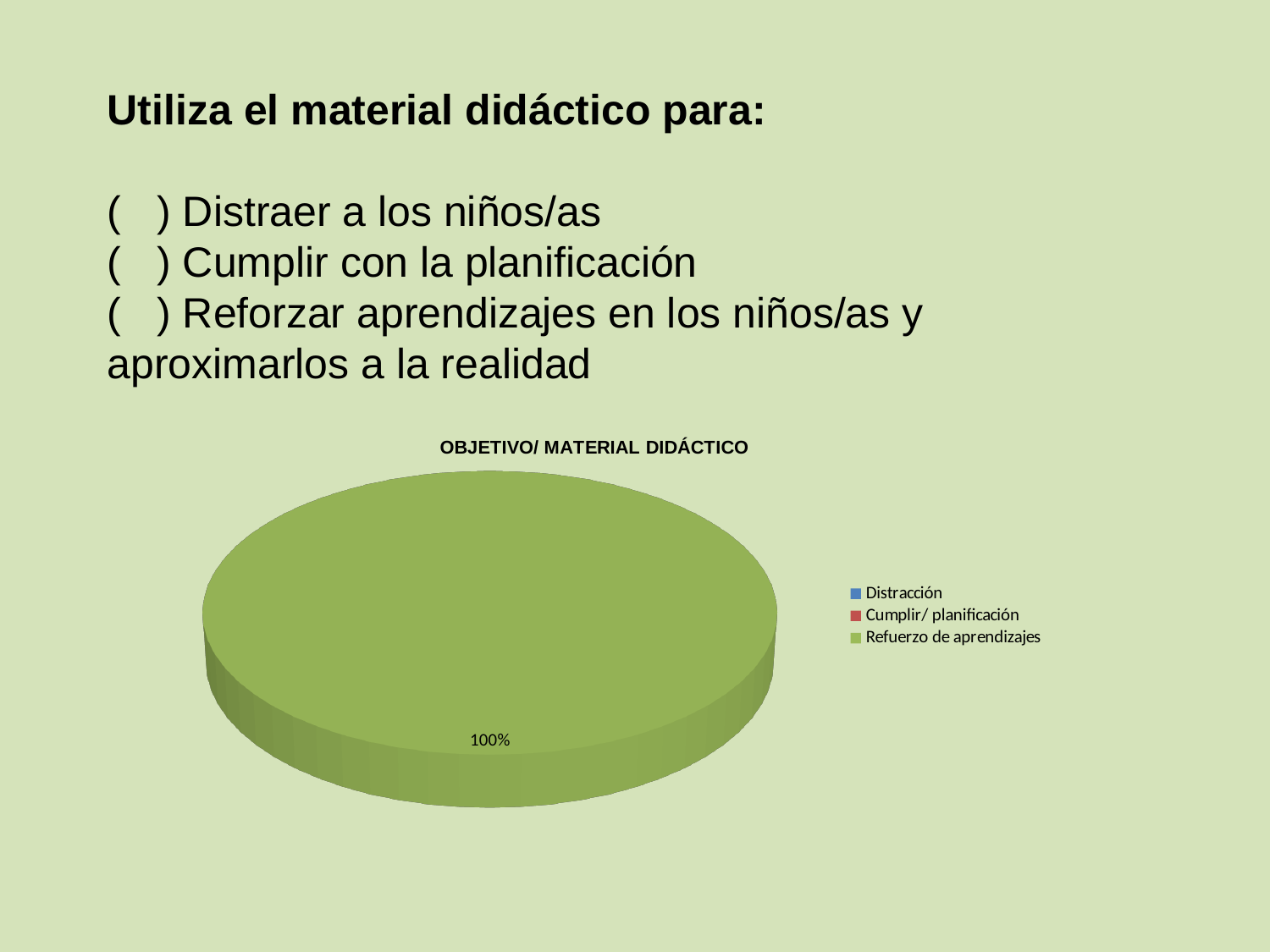
What is the title of the chart? OBJETIVO/ MATERIAL DIDÁCTICO What share of the pie does Refuerzo de aprendizajes have? 100% Which is larger, the share for Refuerzo de aprendizajes or the share for Distracción? Refuerzo de aprendizajes What is the only percentage label printed on the pie? 100% What kind of chart is shown on the slide? pie chart What colour is the slice for Refuerzo de aprendizajes? green How many categories does the chart's legend list? 3 Which is larger, the share for Cumplir/ planificación or the share for Refuerzo de aprendizajes? Refuerzo de aprendizajes Which category has the largest share of the pie? Refuerzo de aprendizajes